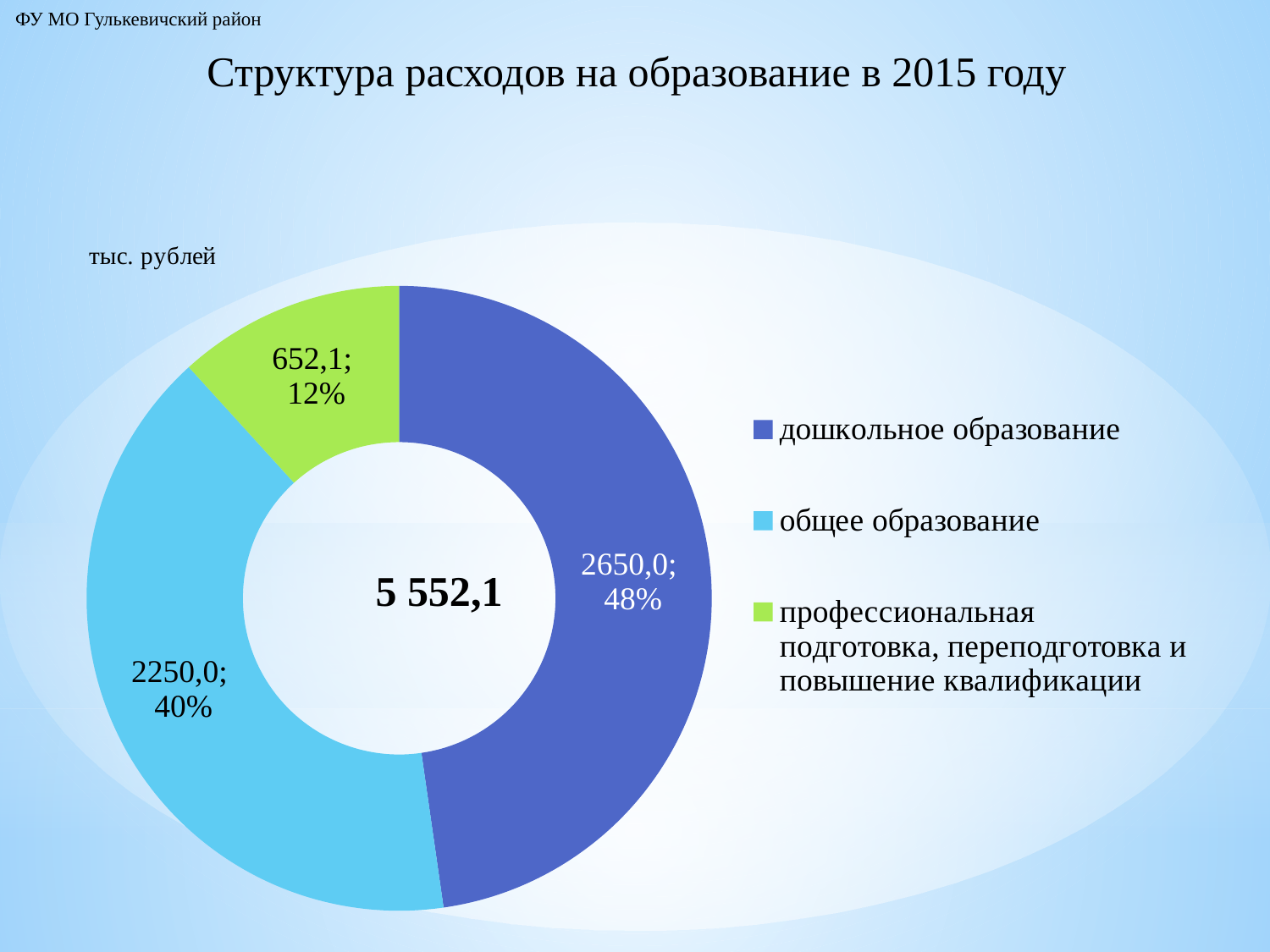
What is the value for общее образование? 2250,0 What is the value for профессиональная подготовка, переподготовка и повышение квалификации? 652,1 Which is larger, the value for общее образование or the value for профессиональная подготовка, переподготовка и повышение квалификации? общее образование What kind of chart is shown on the slide? doughnut (pie) chart What share of the chart does общее образование represent? 40% What is the value for дошкольное образование? 2650,0 Which category has the largest share of the chart? дошкольное образование What total value is shown in the centre of the chart? 5 552,1 Which category has the smallest share of the chart? профессиональная подготовка, переподготовка и повышение квалификации What is the difference between the values for дошкольное образование and общее образование? 400,0 How many categories are shown in the chart? 3 What share of the chart does дошкольное образование represent? 48%